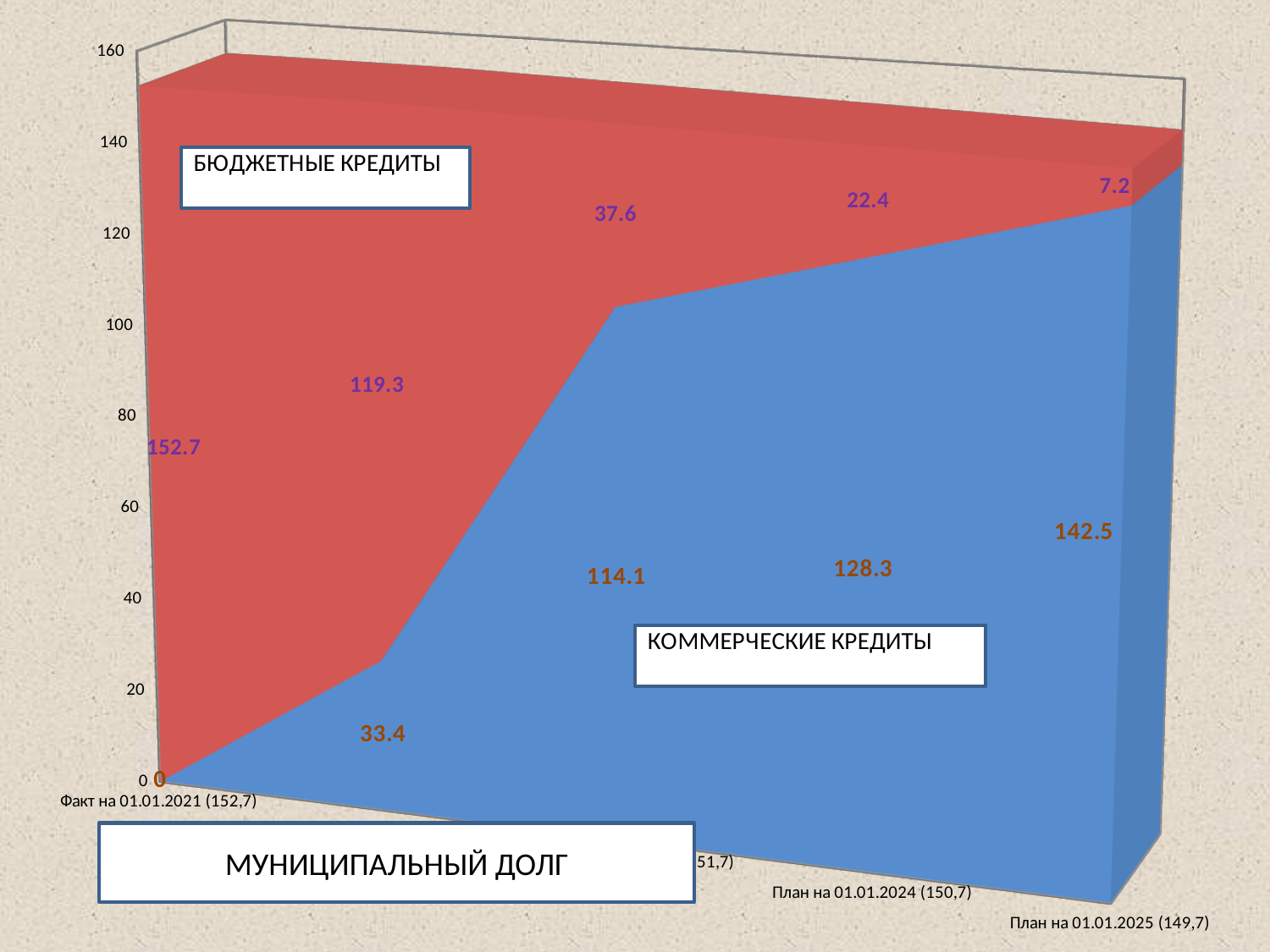
What is the value of Коммерческие кредиты for План на 01.01.2025? 142.5 What is the value of Коммерческие кредиты for План на 01.01.2024? 128.3 What is the value of Бюджетные кредиты for План на 01.01.2024? 22.4 What type of chart is shown on the slide? Stacked area chart How many data points does each series have? 5 What is the value of Бюджетные кредиты for План на 01.01.2025? 7.2 What is the value of Бюджетные кредиты for Факт на 01.01.2021? 152.7 At which point is Бюджетные кредиты lowest? План на 01.01.2025 Do the values of Бюджетные кредиты rise or fall from left to right along the x axis? Fall What is the value of Коммерческие кредиты for Факт на 01.01.2021? 0 At which point is Коммерческие кредиты highest? План на 01.01.2025 What is the difference between Коммерческие кредиты and Бюджетные кредиты for План на 01.01.2025? 135.3